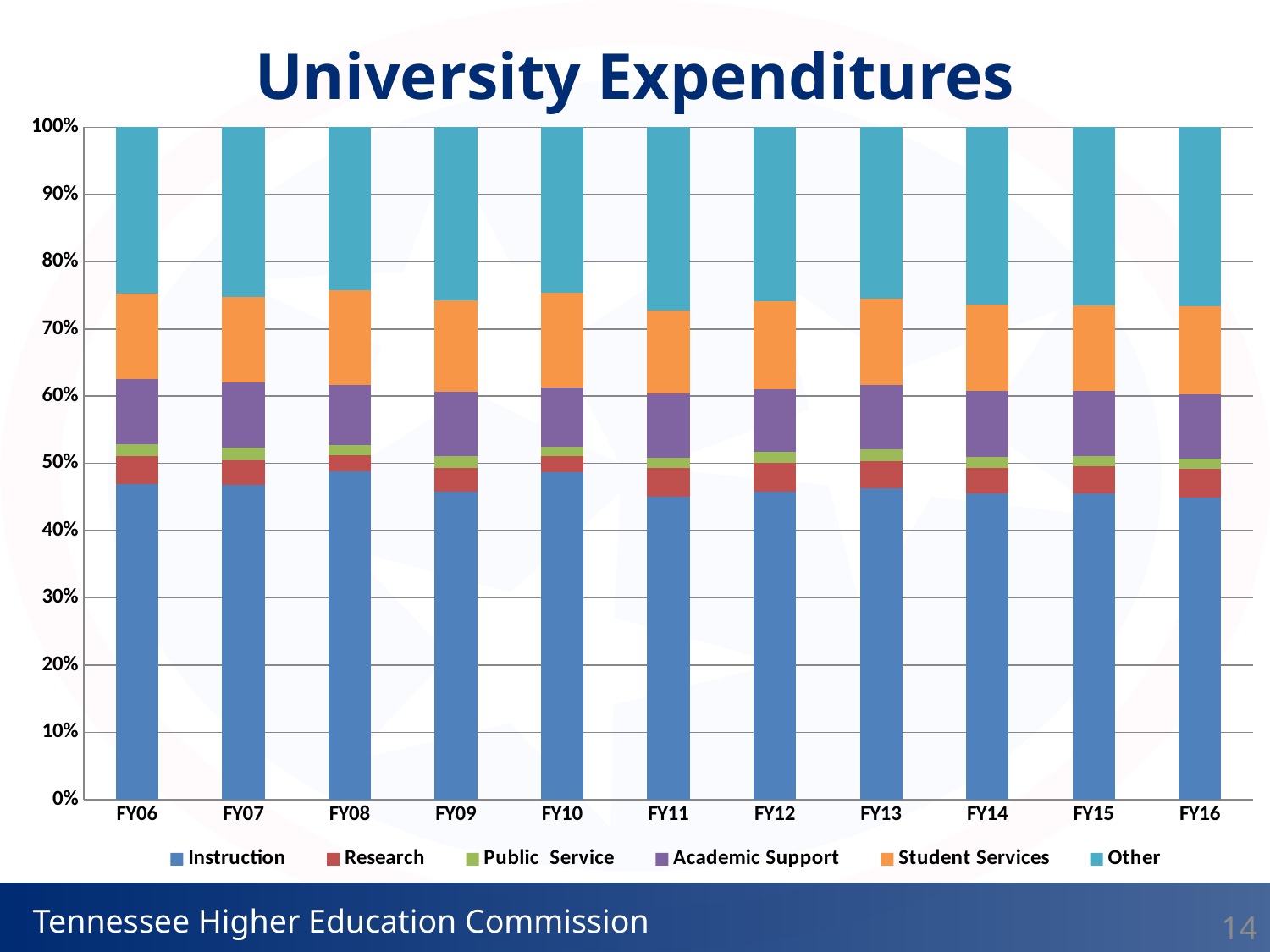
What is the title of the chart? University Expenditures How many series does the legend list? 6 Which series is listed first in the legend? Instruction What is the total of the stacked bar for FY06? 100% Is the cumulative top of the Student Services segment for FY11 greater or less than 80%? less What kind of chart is shown on the slide? stacked bar chart How many fiscal years are shown on the x axis? 11 In the FY06 bar, which segment is larger: Academic Support or Research? Academic Support Which series takes up the smallest share of the FY13 bar? Public Service Is the Instruction value for FY16 greater or less than 50%? less Which series takes up the largest share of the FY10 bar? Instruction Is the Instruction value for FY06 greater or less than 40%? greater